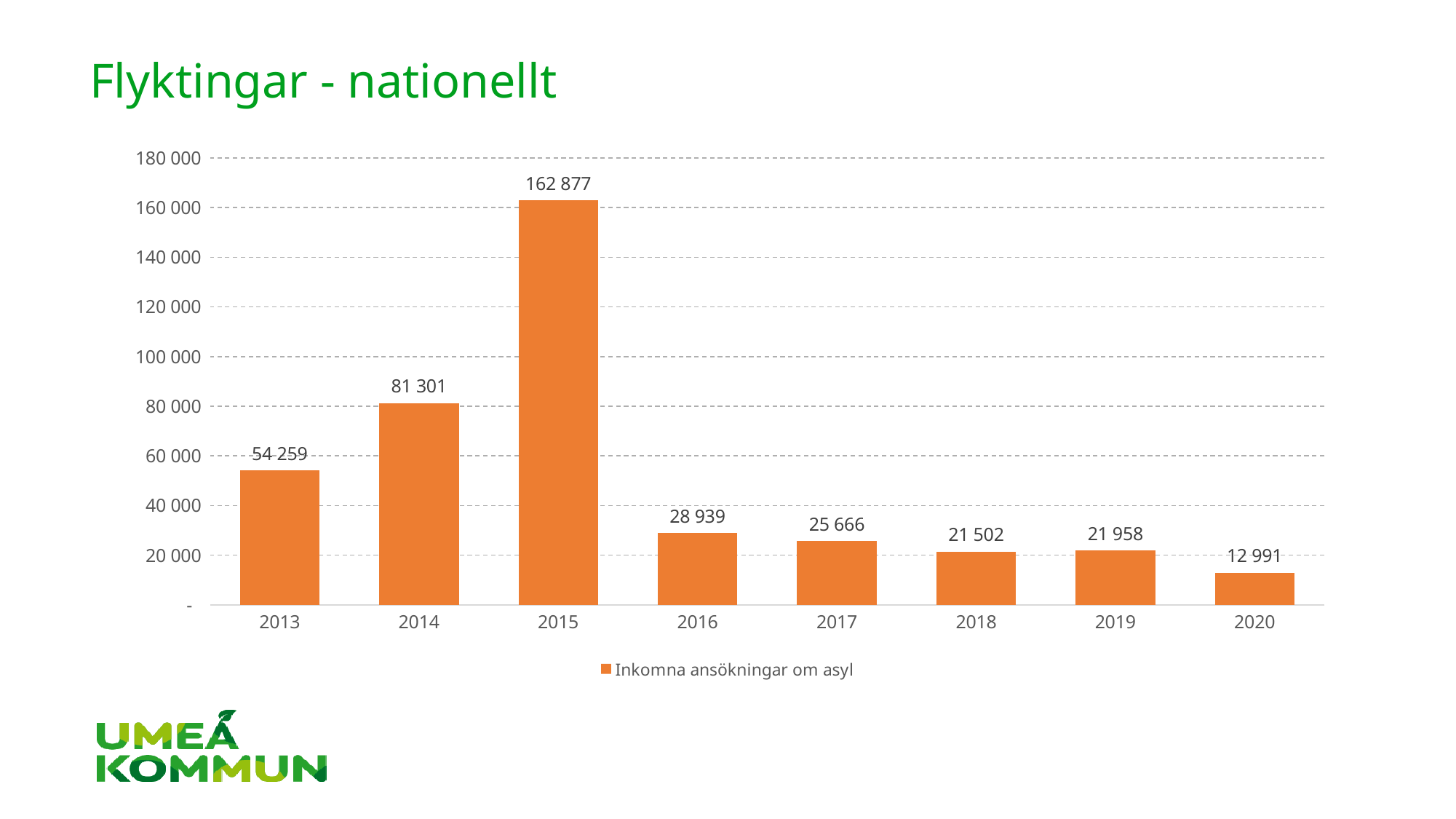
What kind of chart is shown on the slide? bar chart What is the difference between the values for 2016 and 2017? 3 273 What is the legend entry for the series shown? Inkomna ansökningar om asyl Which is larger, the value for 2013 or the value for 2016? 2013 How many years are shown on the x axis? 8 What is the value for 2017? 25 666 What is the value for 2020? 12 991 What is the value for 2015? 162 877 Which year has the lowest value? 2020 What is the difference between the values for 2015 and 2014? 81 576 Which year has the highest value? 2015 Is the value for 2014 greater or less than 80 000? greater